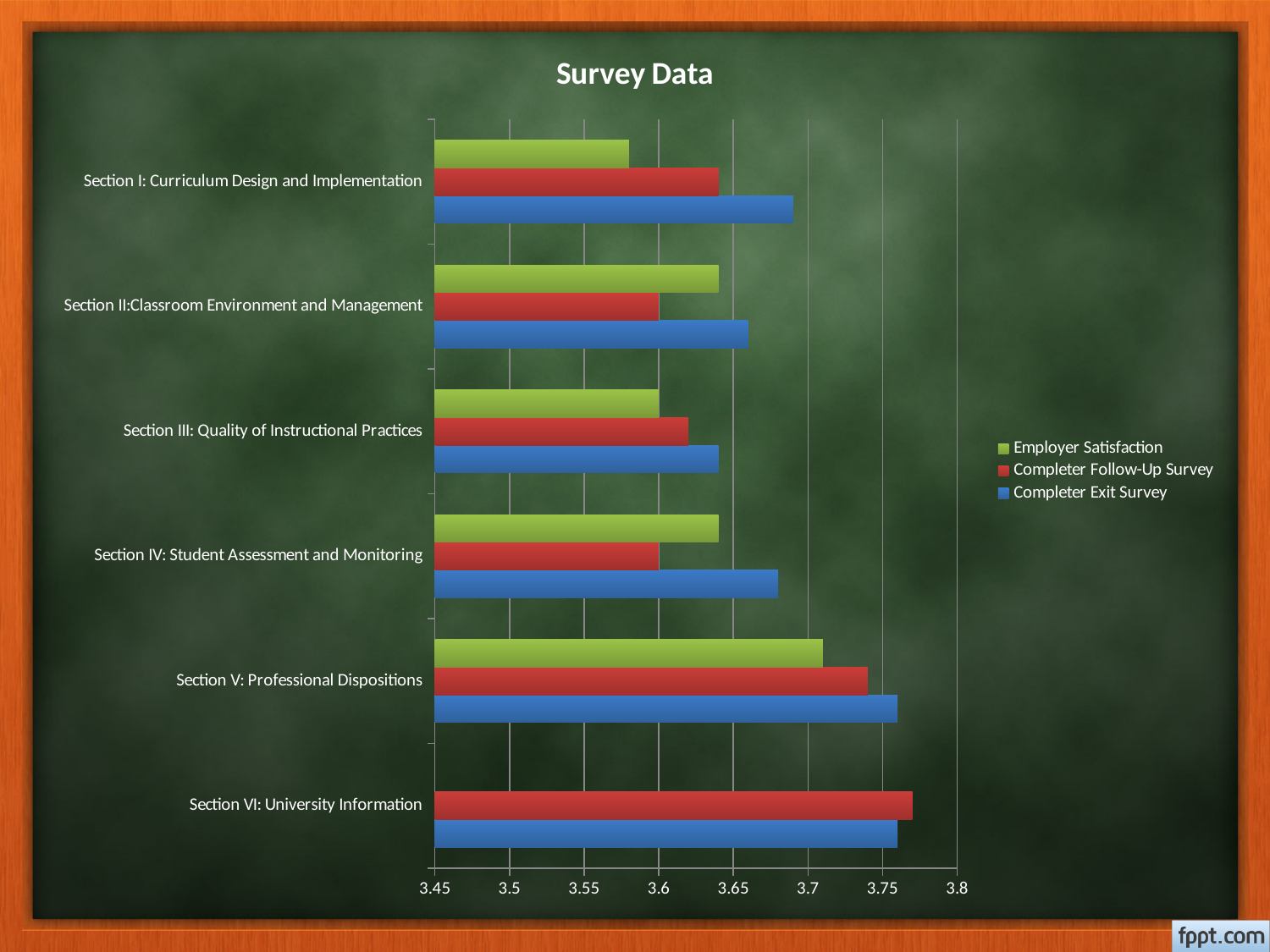
What kind of chart is shown on the slide? Bar chart How many series does the legend list? 3 Is the Employer Satisfaction value for Section I: Curriculum Design and Implementation greater or less than 3.6? less How many sections (categories) are shown on the vertical axis? 6 Which section has the highest Completer Follow-Up Survey value? Section VI: University Information What is the title of the chart? Survey Data For Section I: Curriculum Design and Implementation, which is larger: the Completer Exit Survey value or the Employer Satisfaction value? Completer Exit Survey Is the Completer Follow-Up Survey value for Section V: Professional Dispositions greater or less than 3.7? greater Which section has no Employer Satisfaction bar plotted? Section VI: University Information Which section has the highest Employer Satisfaction value? Section V: Professional Dispositions Is the Completer Exit Survey value for Section I: Curriculum Design and Implementation greater or less than 3.65? greater Which section has the lowest Completer Exit Survey value? Section III: Quality of Instructional Practices